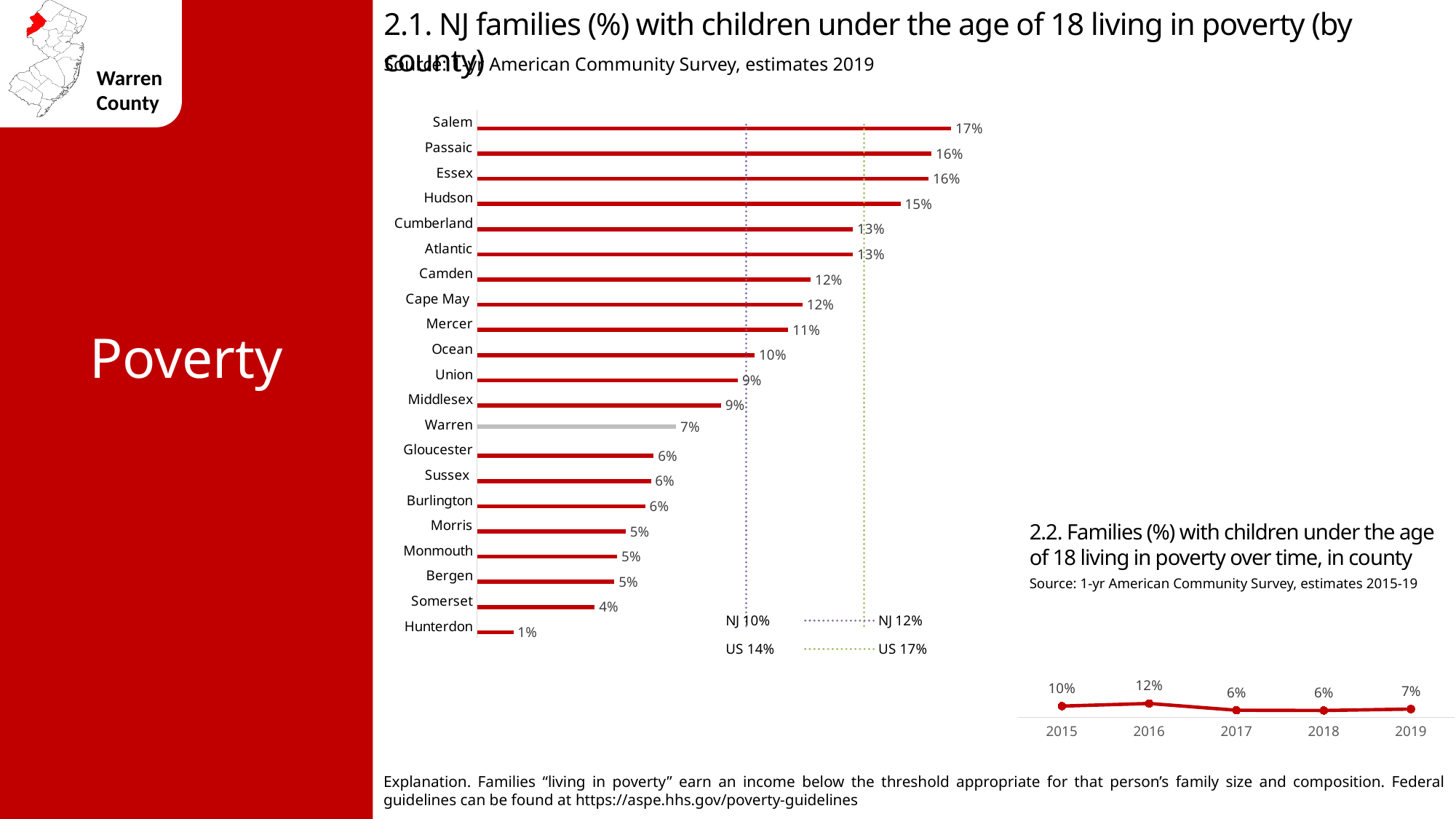
In chart 2.1, what is the difference between the values for Salem and Hunterdon? 16% What kind of chart is chart 2.1? Bar chart In chart 2.2, how many years are plotted? 5 In chart 2.2, what is the difference between the values for 2016 and 2019? 5% In chart 2.1, what is the value for Cumberland? 13% In chart 2.1, how many counties are shown? 21 In chart 2.2, what is the value for 2016? 12% In chart 2.1, which county has the highest value? Salem In chart 2.1, which is larger, the value for Hudson or the value for Mercer? Hudson In chart 2.1, which county has the lowest value? Hunterdon In chart 2.2, which year has the highest value? 2016 In chart 2.1, what is the value for Warren? 7%